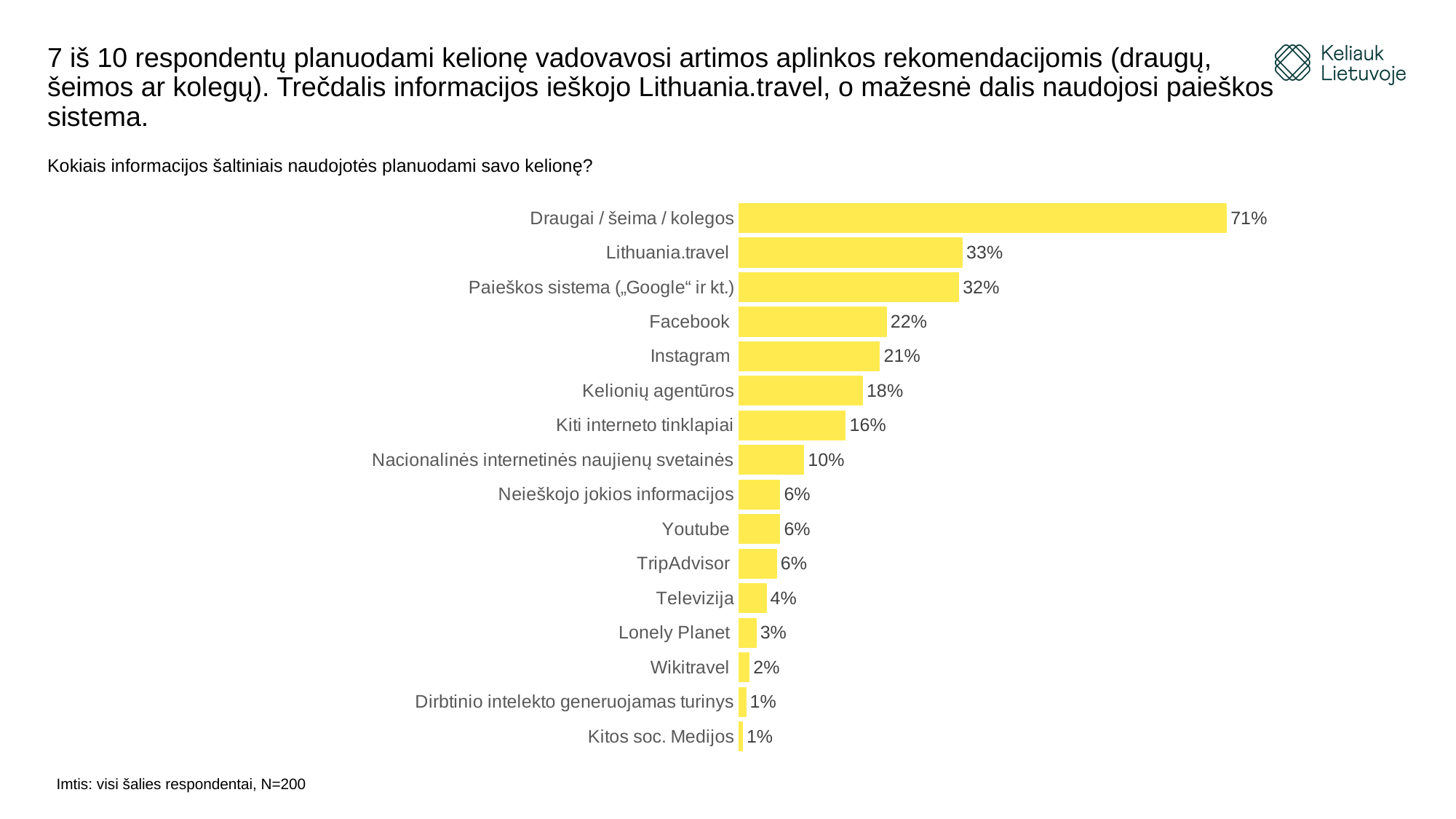
Which has a larger value, Televizija or Lonely Planet? Televizija What is the difference between the values for Draugai / šeima / kolegos and Lithuania.travel? 38% What kind of chart is shown on the slide? bar chart What is the value shown for Kelionių agentūros? 18% What is the value shown for Wikitravel? 2% What is the difference between the values for Facebook and Instagram? 1% How many information sources (categories) are listed in the chart? 16 Which has a larger value, Kiti interneto tinklapiai or Nacionalinės internetinės naujienų svetainės? Kiti interneto tinklapiai What is the value shown for Lithuania.travel? 33% What question is the chart answering, as written above it? Kokiais informacijos šaltiniais naudojotės planuodami savo kelionę? What percentage of respondents used Draugai / šeima / kolegos as an information source? 71% Which information source has the highest value in the chart? Draugai / šeima / kolegos